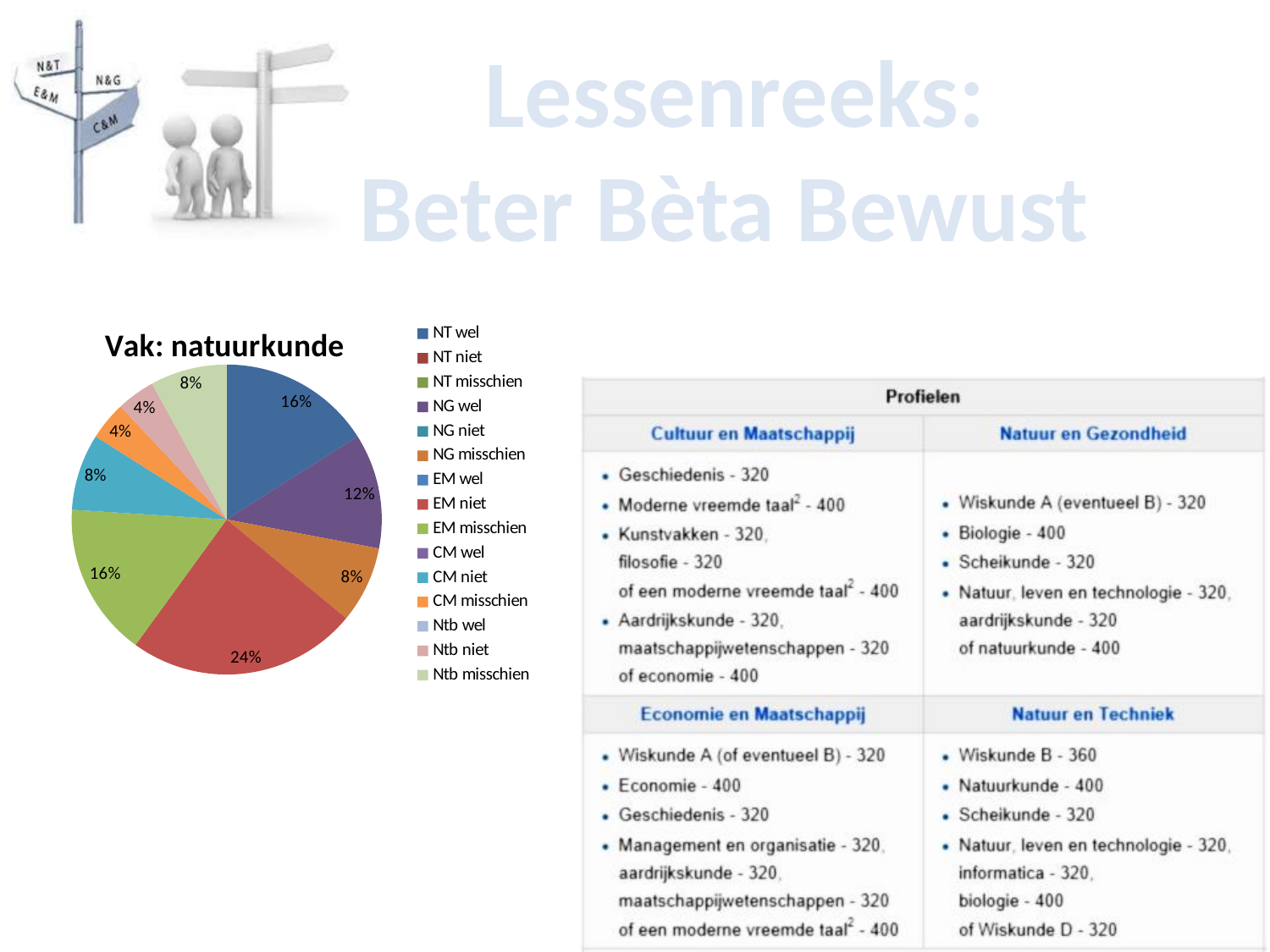
What is the percentage of the smallest slices in the pie chart? 4% How many slices in the pie chart are labelled 16%? 2 Which legend entry is listed first in the pie chart's legend? NT wel What is the difference between the largest slice (24%) and a smallest slice (4%) in the pie chart? 20% How many entries does the legend of the pie chart list? 15 How many slices does the pie chart have? 9 Which is larger in the pie chart: the red slice or the purple slice? the red slice How many slices in the pie chart are labelled 8%? 3 What is the percentage of the largest slice in the pie chart? 24% What is the title of the pie chart? Vak: natuurkunde What share of the pie does the dark blue slice for NT wel represent? 16% What kind of chart is shown on the slide? pie chart